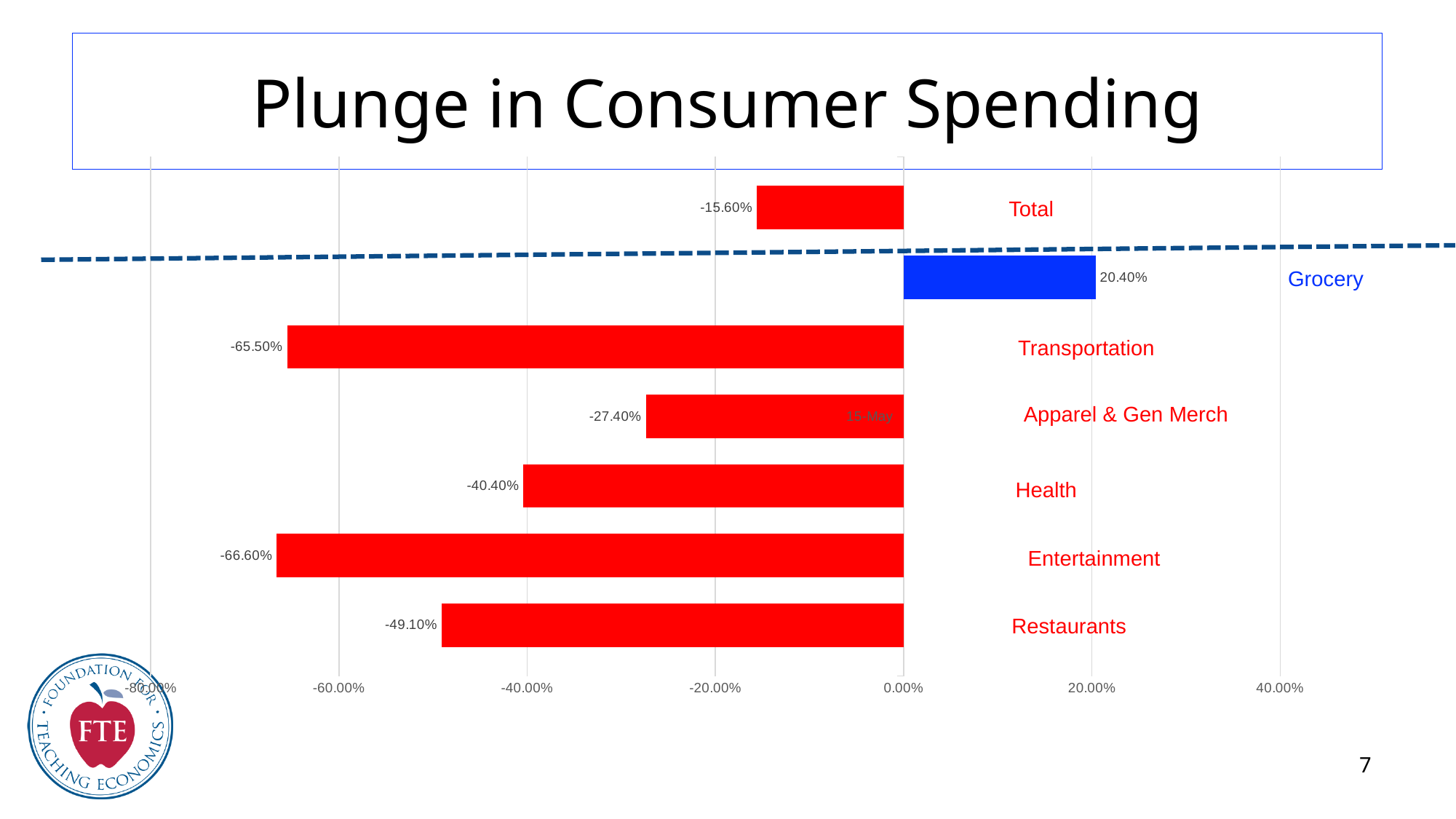
What is the difference between the values for Health and Apparel & Gen Merch? 13.00% What is the title of the slide? Plunge in Consumer Spending What kind of chart is shown on the slide? Bar chart What is the value for Transportation? -65.50% Which category has the highest value? Grocery What is the value for Total? -15.60% How many categories are shown in the chart? 7 Which has a larger value, Health or Restaurants? Health Which category's bar is coloured blue rather than red? Grocery Which category has the lowest value? Entertainment What is the value for Grocery? 20.40% What is the value for Restaurants? -49.10%